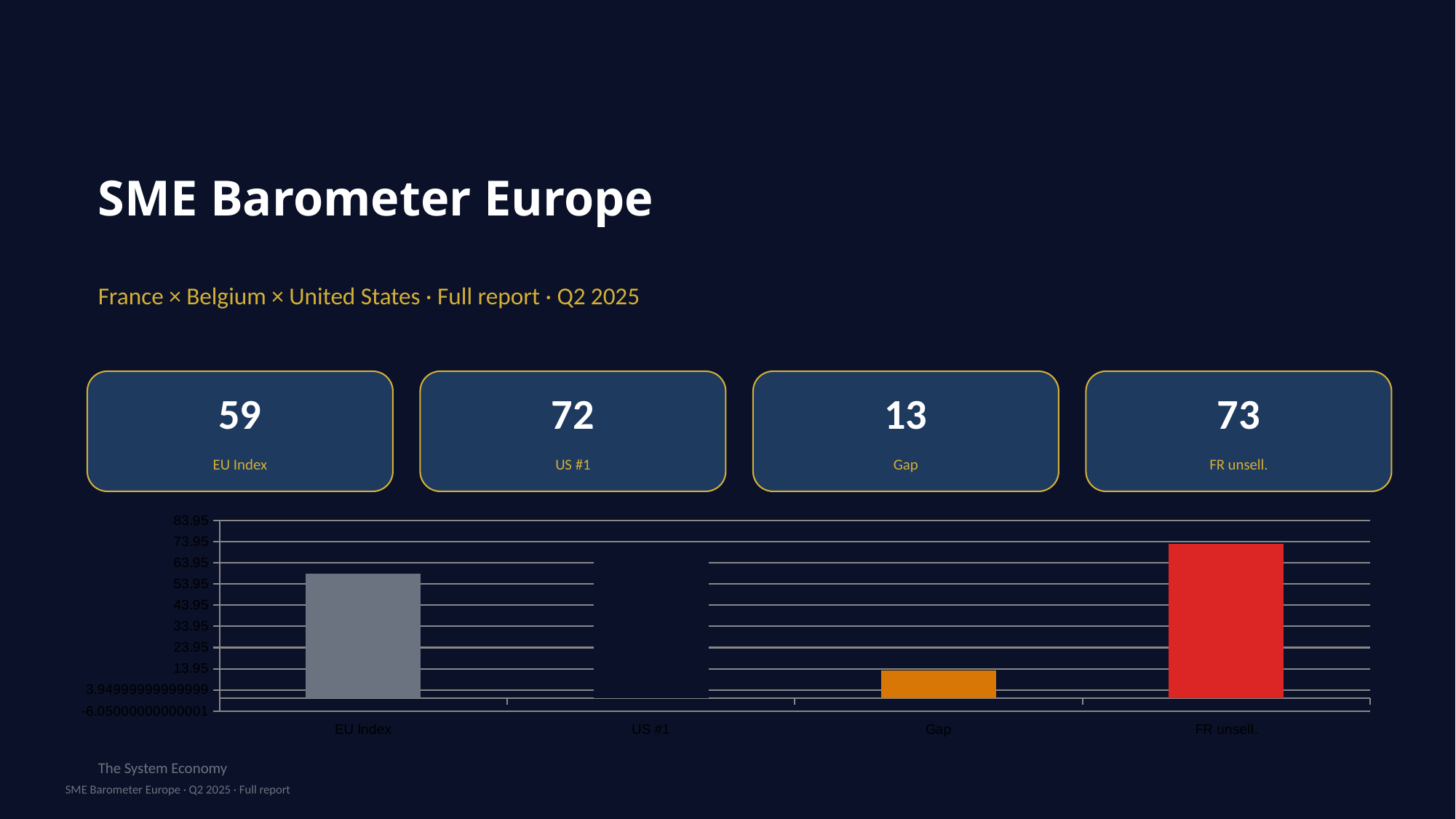
What is the value for FR unsell.? 73 What is the difference between the value for EU Index and the value for Gap? 46 What is the value for Gap? 13 Which category has the lowest value in the bar chart? Gap How many categories are shown on the x axis of the bar chart? 4 Which is larger, the value for EU Index or the value for FR unsell.? FR unsell. What kind of chart is shown on the slide? bar chart What is the difference between the value for FR unsell. and the value for EU Index? 14 What is the title of the slide containing the chart? SME Barometer Europe What is the value for EU Index? 59 What is the value for US #1? 72 What colour is the bar for FR unsell.? red